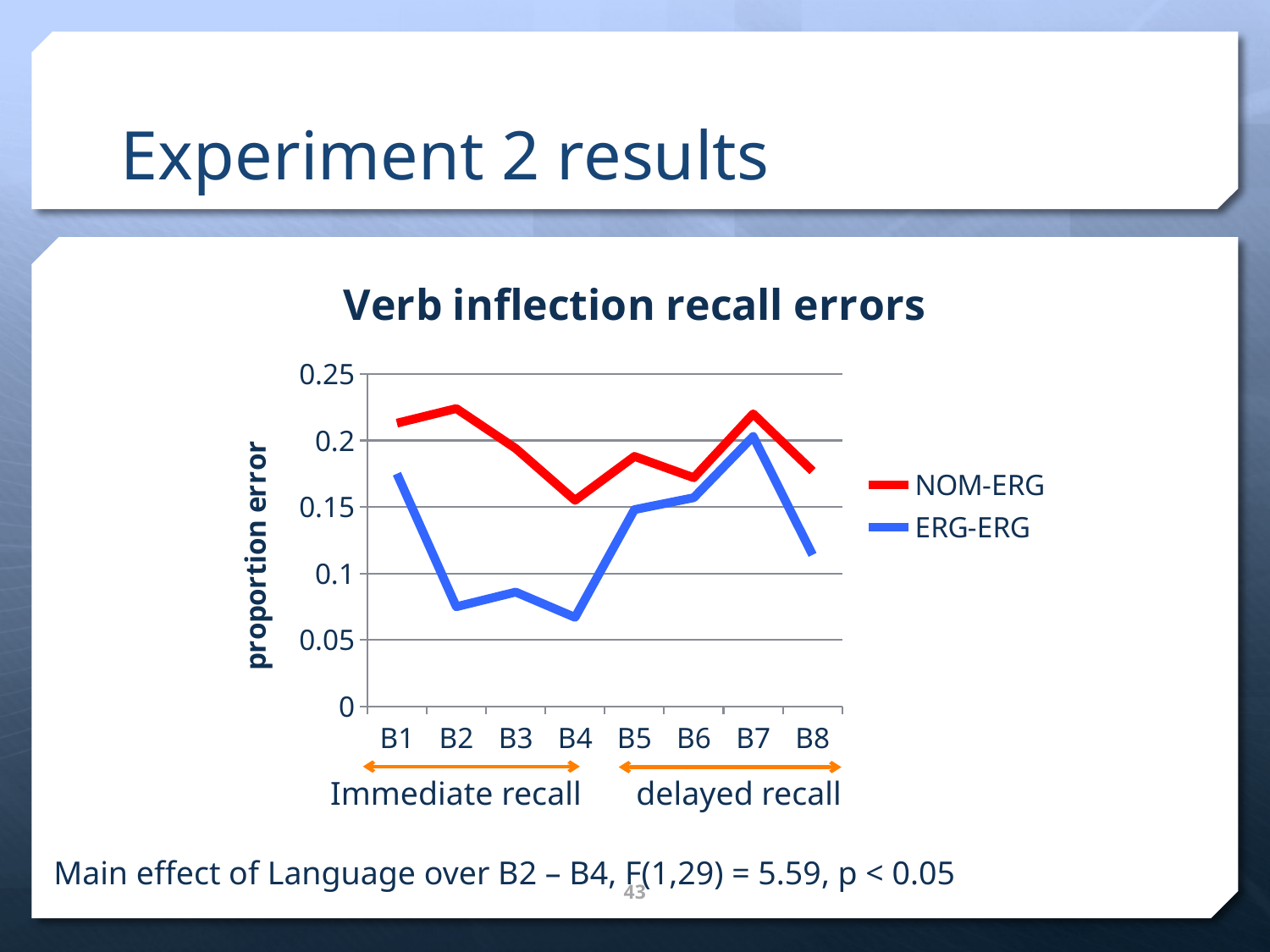
At which block does the ERG-ERG series reach its highest value? B7 At B4, which series has the larger value, NOM-ERG or ERG-ERG? NOM-ERG How many series does the legend list? 2 What kind of chart is shown on the slide? line chart Is the value for ERG-ERG at B2 greater or less than 0.1? less Is the value for NOM-ERG at B2 greater or less than 0.2? greater Does the ERG-ERG series rise or fall from B4 to B7? rise Is the value for NOM-ERG at B4 greater or less than 0.2? less What is the label of the y axis? proportion error How many categories are shown on the x axis? 8 What is the title of the chart? Verb inflection recall errors